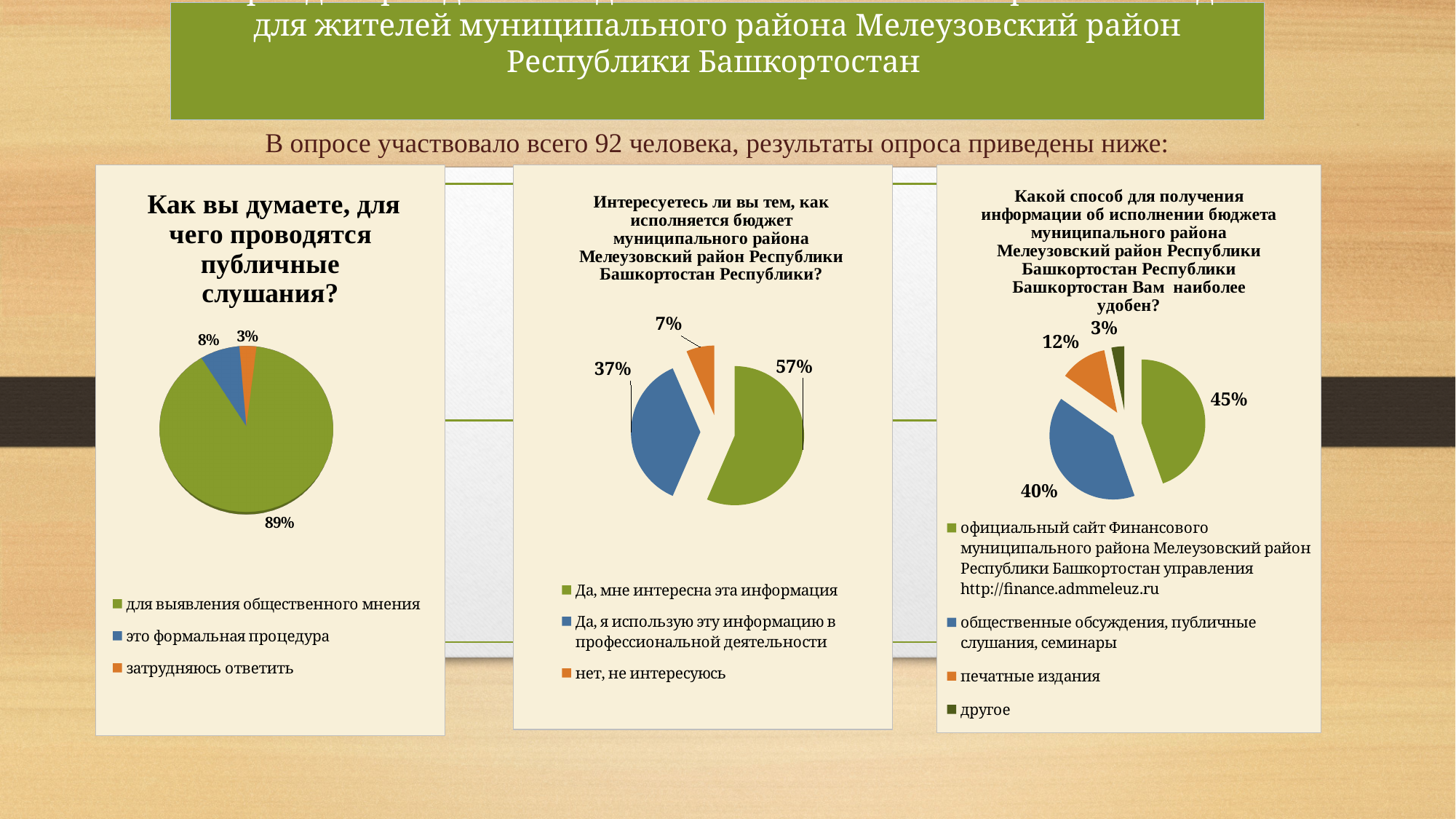
What type of chart is used in the middle panel of the slide? pie chart In the middle pie chart, which category has the largest slice? Да, мне интересна эта информация In the middle pie chart ("Интересуетесь ли вы тем, как исполняется бюджет..."), what share is labelled for "Да, мне интересна эта информация"? 57% In the left pie chart, which category has the smallest slice? затрудняюсь ответить In the right pie chart ("Какой способ для получения информации..."), what share is labelled for "печатные издания"? 12% In the right pie chart, which is larger: the share for "официальный сайт" or the share for "общественные обсуждения, публичные слушания, семинары"? официальный сайт How many slices does the left pie chart have? 3 In the middle pie chart, what share is labelled for "нет, не интересуюсь"? 7% In the middle pie chart, what is the difference between the shares for "Да, мне интересна эта информация" and "Да, я использую эту информацию в профессиональной деятельности"? 20% How many categories does the legend of the right pie chart list? 4